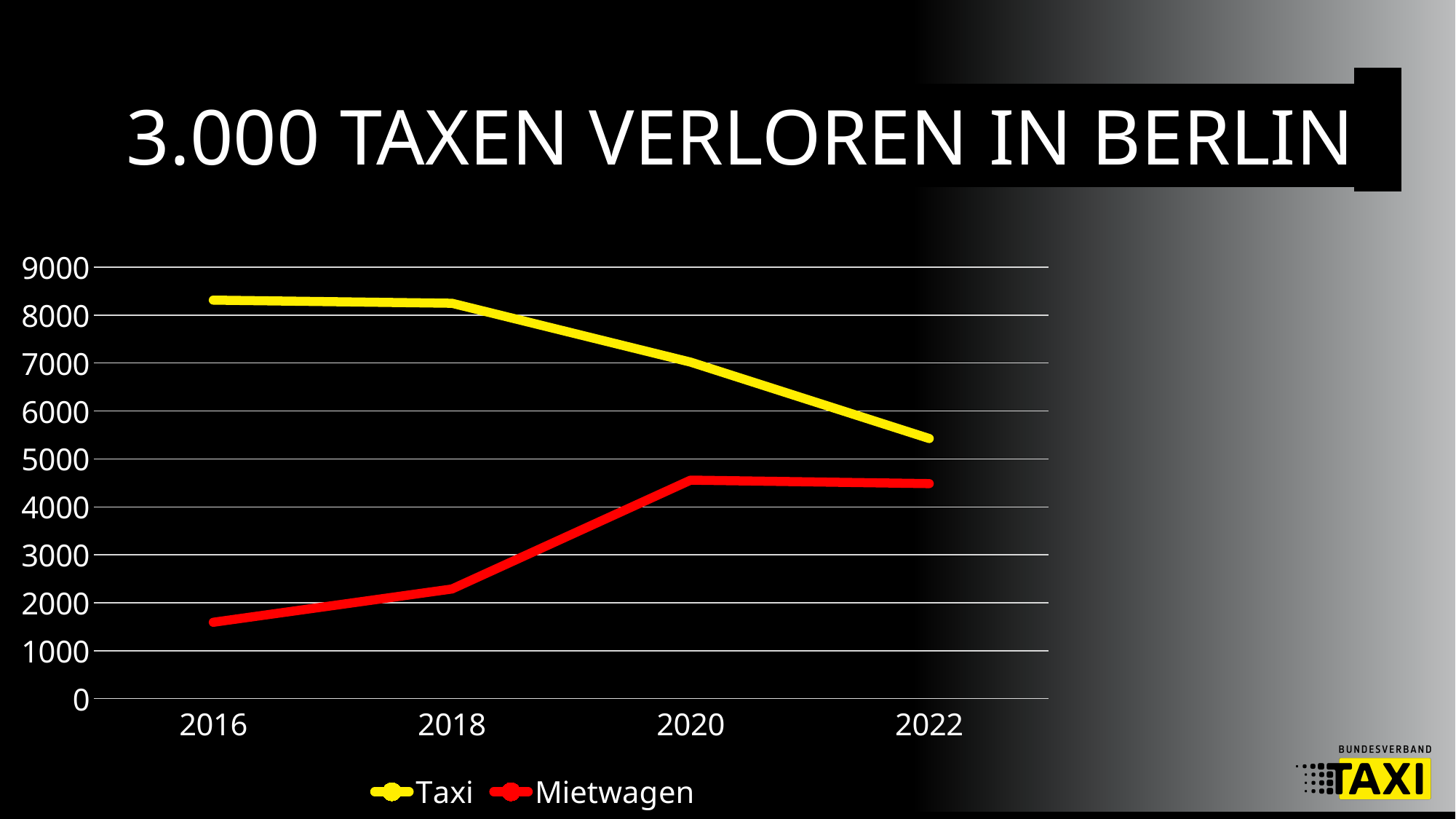
Does the Mietwagen line rise or fall from 2016 to 2022? rise In which year is the Mietwagen value lowest? 2016 In 2022, which series has the larger value, Taxi or Mietwagen? Taxi What is the title of the slide? 3.000 TAXEN VERLOREN IN BERLIN How many series does the legend list? 2 What kind of chart is shown on the slide? line chart In which year is the Taxi value lowest? 2022 Does the Taxi line rise or fall from 2016 to 2022? fall How many years are plotted along the x axis? 4 Is the Taxi value for 2016 greater or less than 8000? greater Is the Taxi value for 2022 greater or less than 6000? less Is the Mietwagen value for 2016 greater or less than 2000? less